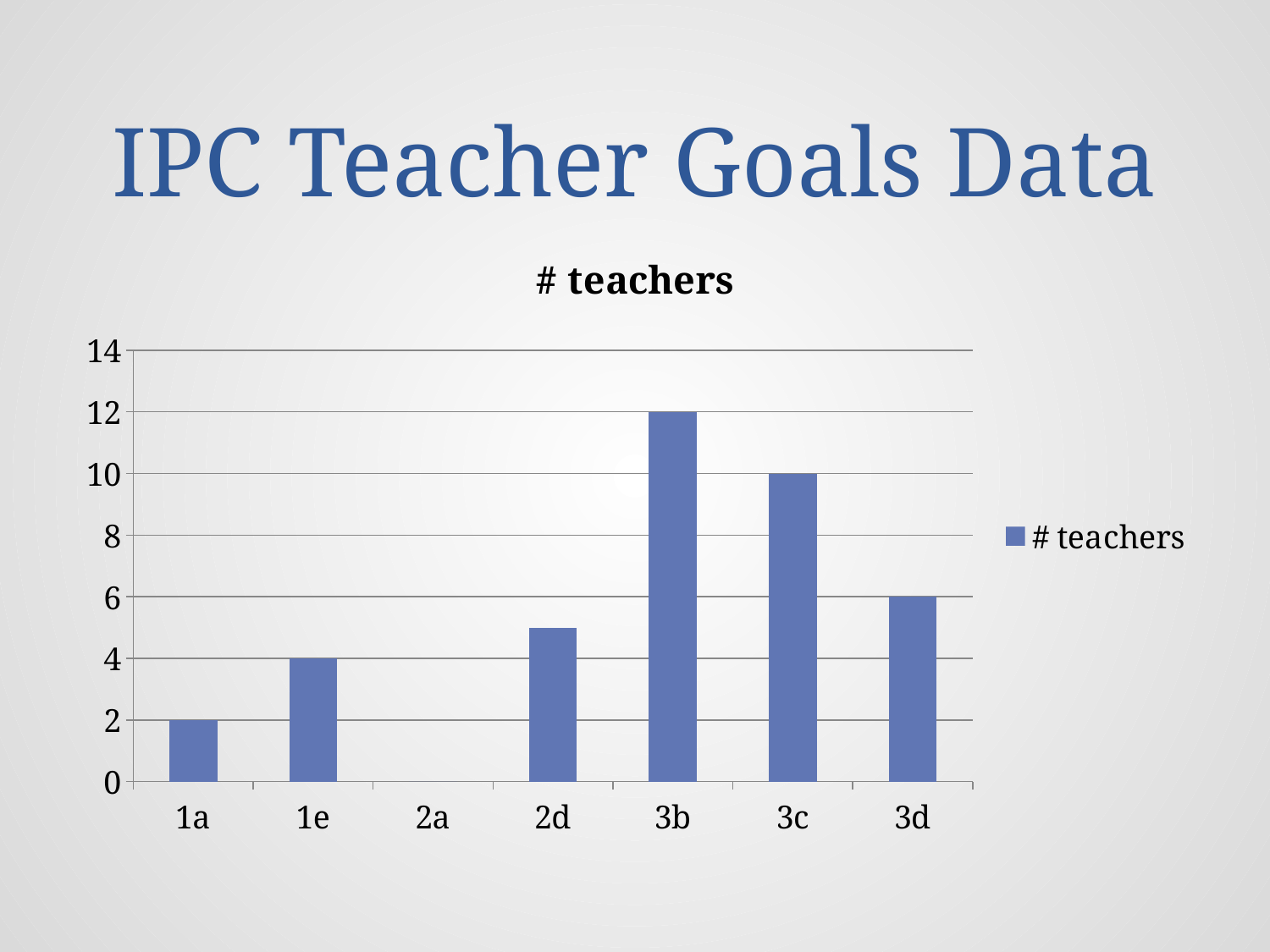
What kind of chart is shown on the slide? bar chart Which has more teachers, category 1e or category 3d? 3d What is the number of teachers for category 1a? 2 Is the value for 2d greater or less than 4? greater What is the difference between the number of teachers for 3b and for 3c? 2 How many categories are shown on the x axis? 7 Which category has the highest number of teachers? 3b What is the number of teachers for category 3c? 10 What is the number of teachers for category 3b? 12 What is the number of teachers for category 3d? 6 Which category has the lowest number of teachers? 2a What is the title of the chart? # teachers